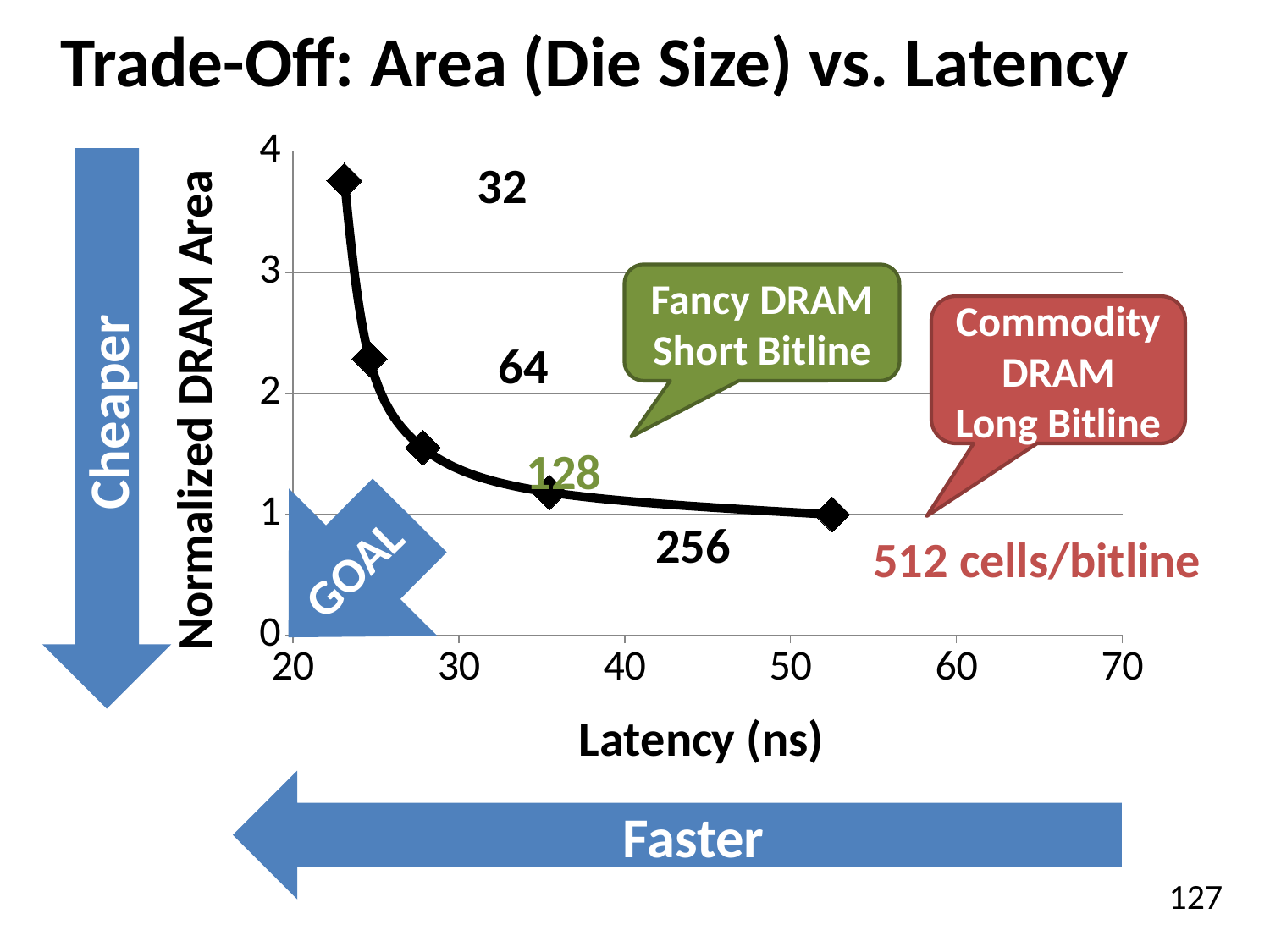
What is the label of the x axis? Latency (ns) Is the Normalized DRAM Area for the 64 cells/bitline point greater or less than 2? greater Which has a larger Normalized DRAM Area, the 64 point or the 128 point? 64 Is the Normalized DRAM Area for the 32 cells/bitline point greater or less than 3? greater Which data point has the highest Normalized DRAM Area? 32 Which data point has the highest latency? 512 cells/bitline Is the Normalized DRAM Area for the 128 cells/bitline point greater or less than 2? less How many data points are plotted on the chart? 5 As latency increases along the x axis, does the Normalized DRAM Area rise or fall? fall What kind of chart is shown on the slide? line chart What is the title of the chart on the slide? Trade-Off: Area (Die Size) vs. Latency